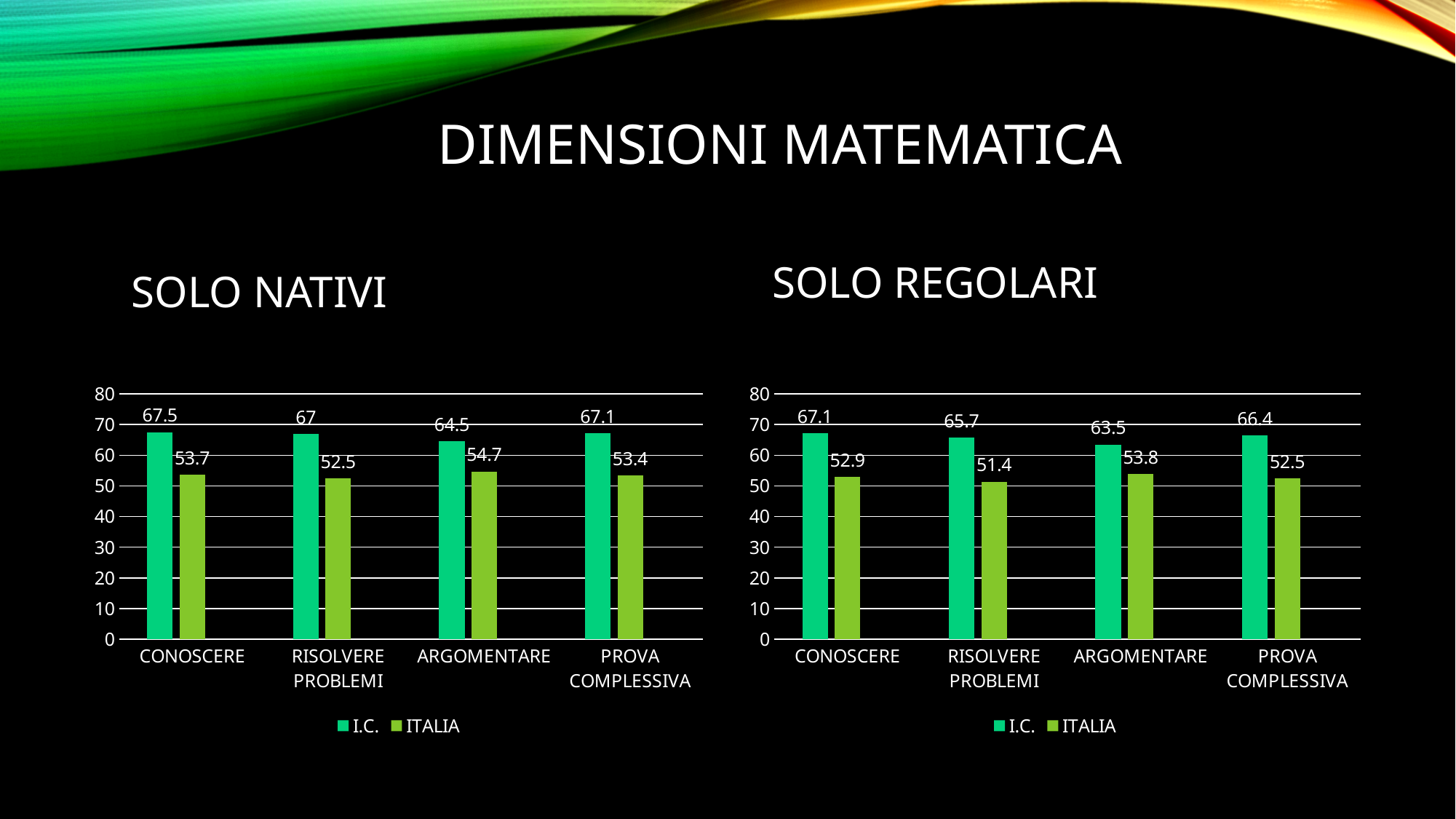
In the SOLO REGOLARI chart, which is larger for RISOLVERE PROBLEMI: I.C. or ITALIA? I.C. In the SOLO REGOLARI chart, what is the difference between the I.C. and ITALIA values for ARGOMENTARE? 9.7 How many series does the legend of the SOLO REGOLARI chart list? 2 How many categories are shown on the x axis of the SOLO NATIVI chart? 4 In the SOLO REGOLARI chart, what is the I.C. value for RISOLVERE PROBLEMI? 65.7 In the SOLO NATIVI chart, what is the I.C. value for CONOSCERE? 67.5 In the SOLO REGOLARI chart, what is the ITALIA value for PROVA COMPLESSIVA? 52.5 In the SOLO REGOLARI chart, which category has the highest ITALIA value? ARGOMENTARE What kind of chart is the SOLO NATIVI chart? Bar chart In the SOLO NATIVI chart, what is the ITALIA value for ARGOMENTARE? 54.7 In the SOLO NATIVI chart, which category has the lowest I.C. value? ARGOMENTARE In the SOLO NATIVI chart, what is the difference between the I.C. and ITALIA values for CONOSCERE? 13.8